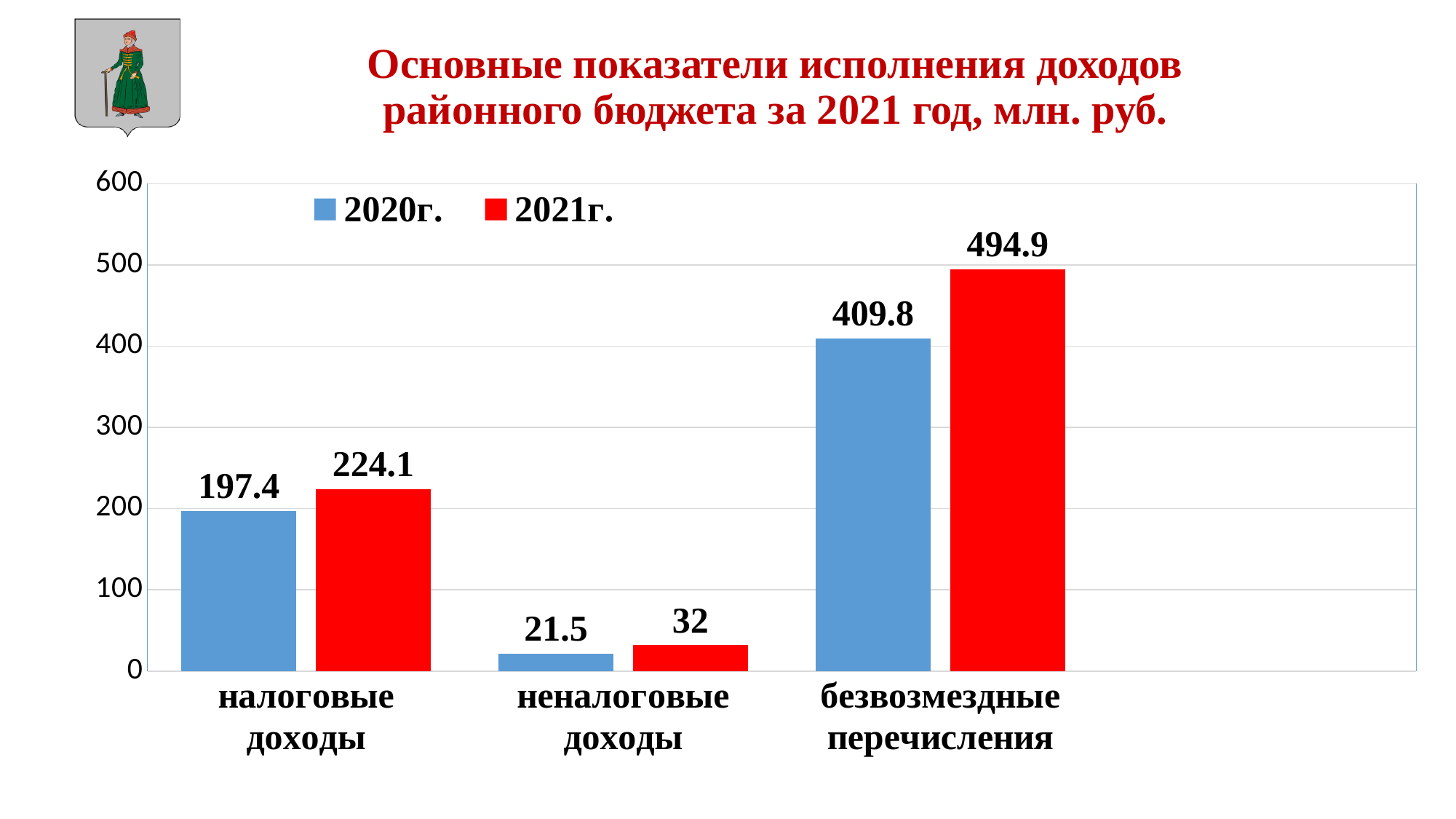
Is the 2020г. value for безвозмездные перечисления greater or less than 400? greater Which category has the highest value in 2020г.? безвозмездные перечисления How many categories are shown on the x axis? 3 What is the difference between the 2021г. and 2020г. values for безвозмездные перечисления? 85.1 How many series does the legend list? 2 What is the difference between the 2021г. and 2020г. values for налоговые доходы? 26.7 What is the value for безвозмездные перечисления in 2021г.? 494.9 Which is larger for неналоговые доходы: the 2020г. value or the 2021г. value? 2021г. What is the value for налоговые доходы in 2021г.? 224.1 What is the value for неналоговые доходы in 2020г.? 21.5 What kind of chart is shown on the slide? bar chart Which category has the lowest value in 2021г.? неналоговые доходы